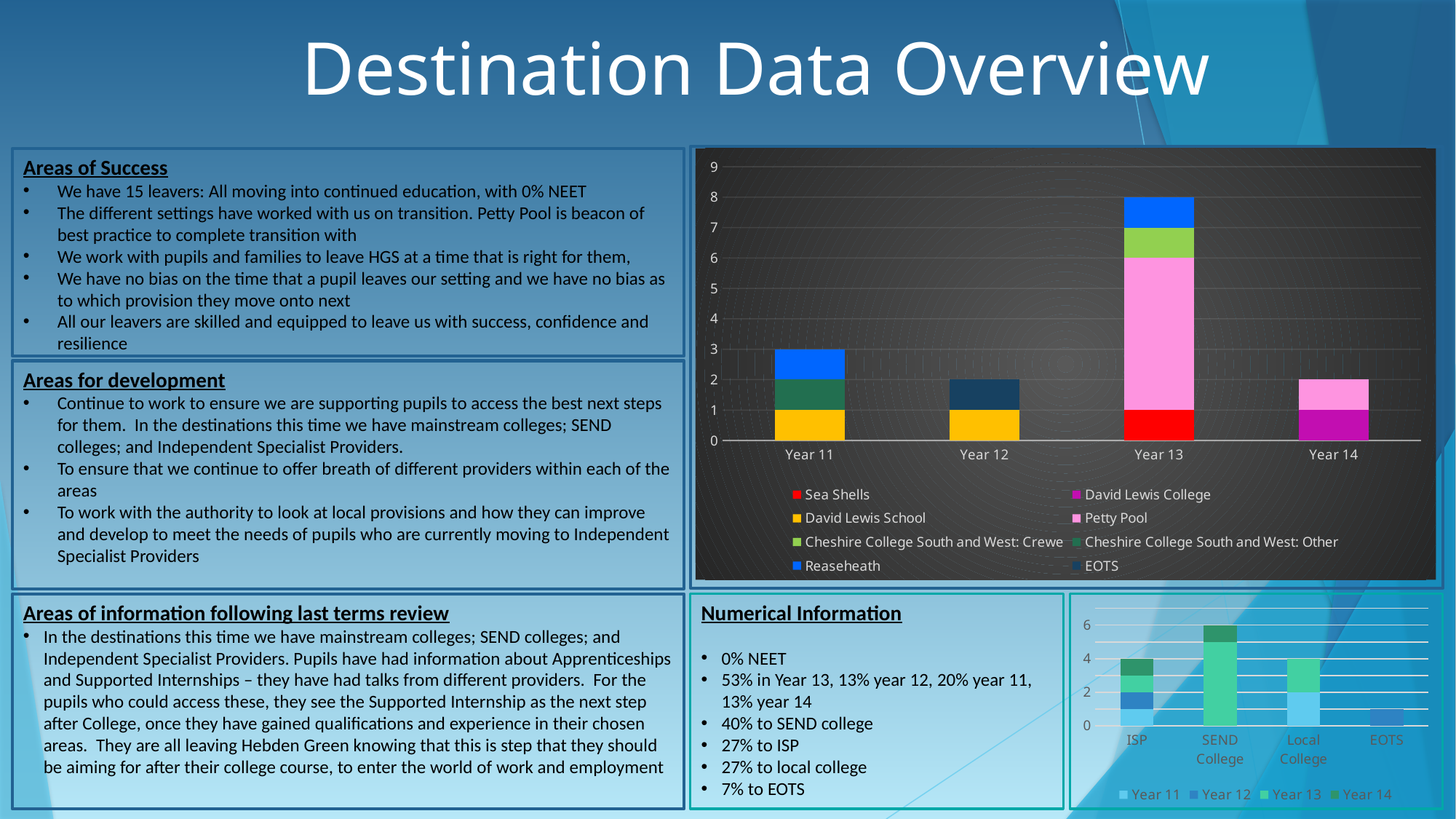
In the large chart at the top right, which year group has the tallest stacked bar? Year 13 In the large chart at the top right, how many series does the legend list? 8 In the large chart at the top right, how many categories are shown on the x axis? 4 In the small chart at the bottom right, how many series does the legend list? 4 In the large chart at the top right, is the stacked bar for Year 11 or Year 12 taller? Year 11 In the small chart at the bottom right, which category has the shortest stacked bar? EOTS What kind of chart is the large chart at the top right of the slide? bar chart In the large chart at the top right, what is the total height of the stacked bar for Year 13? 8 In the large chart at the top right, is the total for Year 13 greater or less than 7? greater In the large chart at the top right, which series is shown in red in the legend? Sea Shells In the small chart at the bottom right, which category has the tallest stacked bar? SEND College In the large chart at the top right, what is the total height of the stacked bar for Year 11? 3